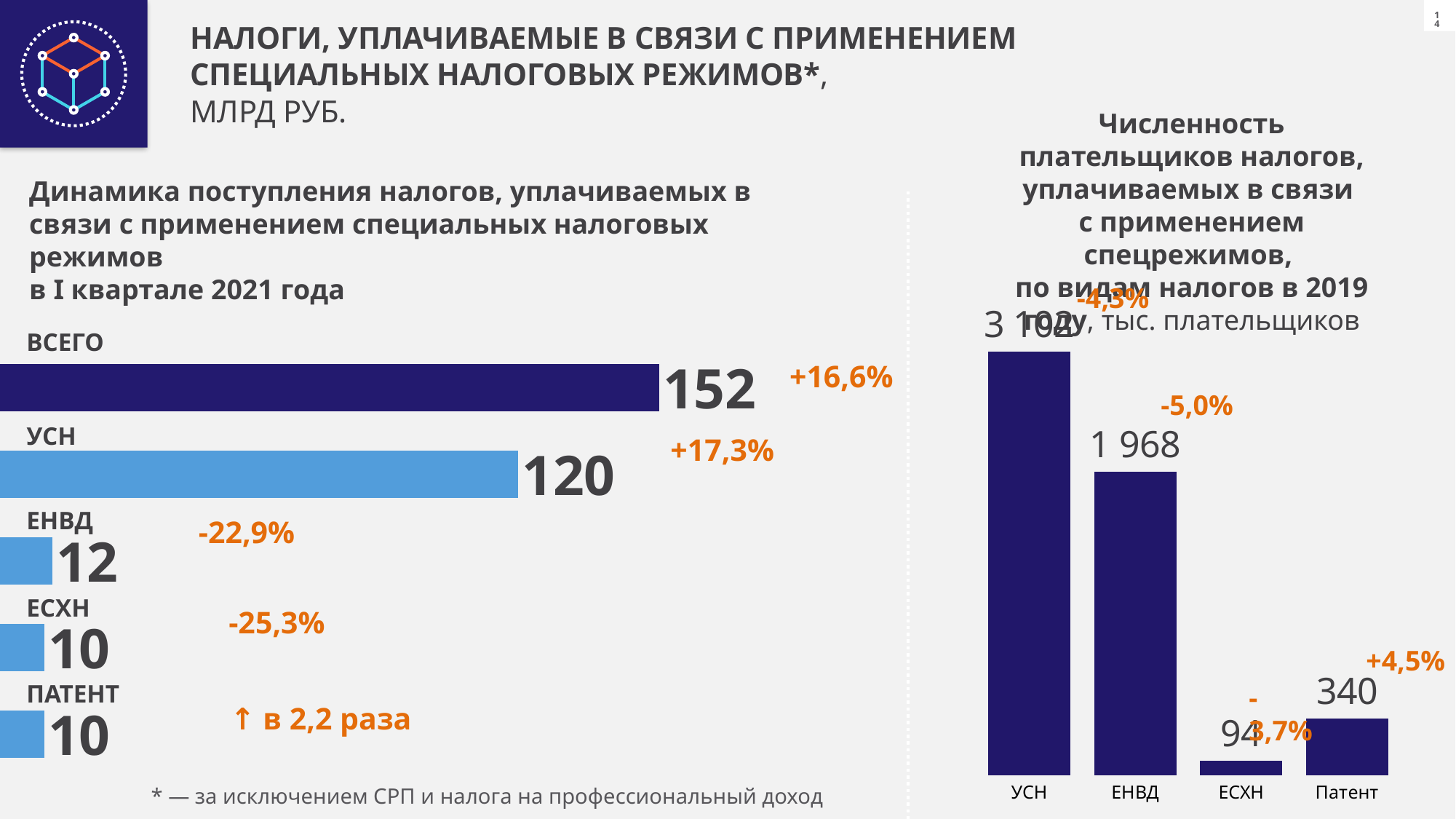
In the right chart (Численность плательщиков налогов), which category has the lowest value? ЕСХН In the left chart (Динамика поступления налогов), what is the value for УСН? 120 In the left chart (Динамика поступления налогов), how many bars are shown? 5 In the left chart (Динамика поступления налогов), what is the difference between the ВСЕГО and УСН values? 32 In the right chart (Численность плательщиков налогов), which category has the highest value? УСН In the left chart (Динамика поступления налогов), what is the value for ЕНВД? 12 What type of chart is the left chart (Динамика поступления налогов)? Bar chart In the left chart (Динамика поступления налогов), what is the value for ВСЕГО? 152 In the left chart (Динамика поступления налогов), what percentage change is shown next to УСН? +17,3% In the right chart (Численность плательщиков налогов), what is the value for ЕНВД? 1 968 In the left chart (Динамика поступления налогов), which of ЕНВД or ЕСХН has the larger value? ЕНВД In the right chart (Численность плательщиков налогов), what is the value for Патент? 340